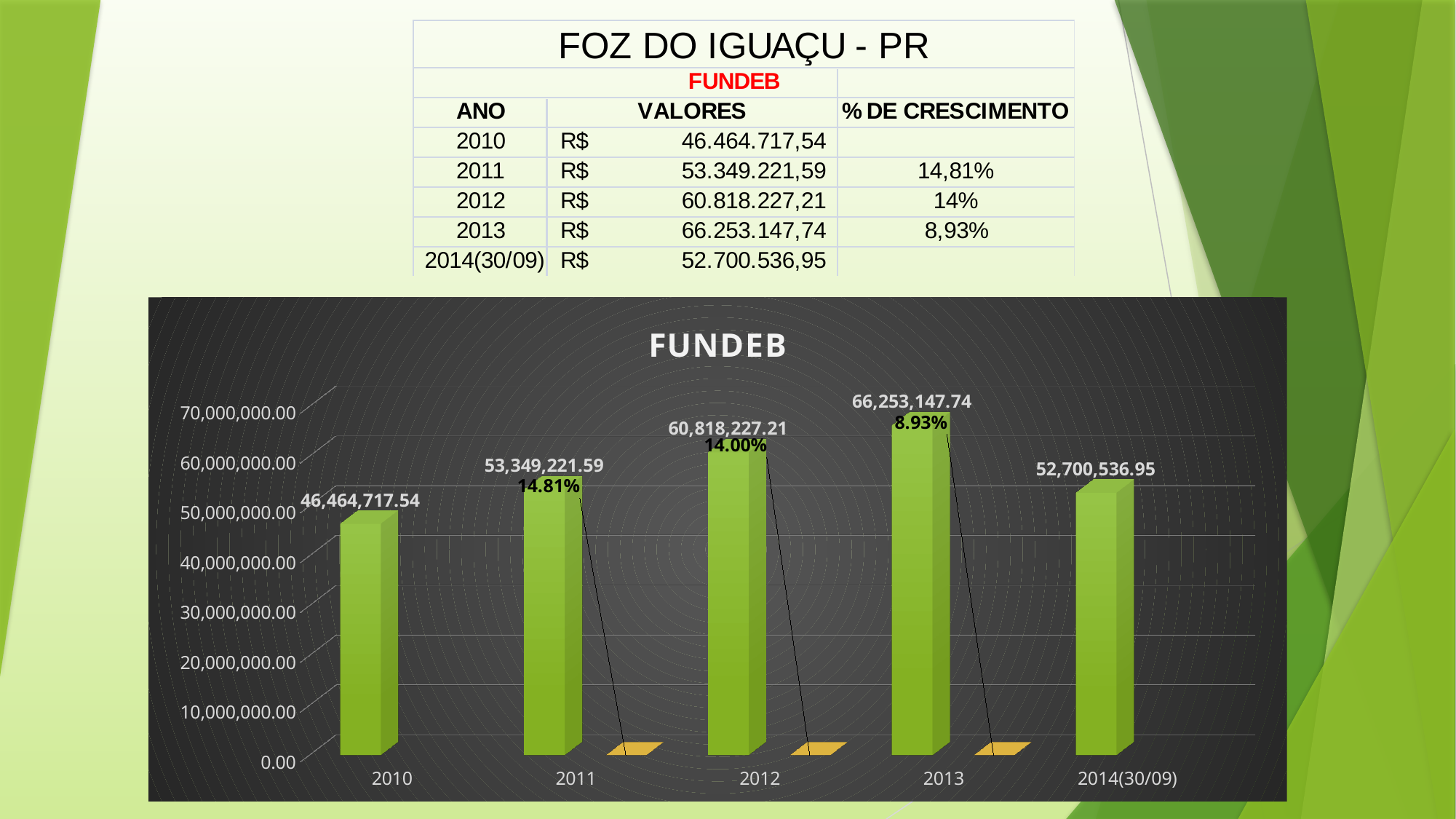
What is the difference between the 2013 and 2014(30/09) values in the FUNDEB chart? 13,552,610.79 Which is larger in the FUNDEB chart, the value for 2012 or the value for 2014(30/09)? 2012 Which year has the lowest value in the FUNDEB chart? 2010 What is the value for 2014(30/09) in the FUNDEB chart? 52,700,536.95 What kind of chart is the FUNDEB chart? bar chart Is the value for 2010 in the FUNDEB chart greater or less than 50,000,000.00? less What is the value for 2010 in the FUNDEB chart? 46,464,717.54 What is the difference between the 2013 and 2010 values in the FUNDEB chart? 19,788,430.20 Which year has the highest value in the FUNDEB chart? 2013 What is the value for 2013 in the FUNDEB chart? 66,253,147.74 What growth percentage is shown above the 2011 bar in the FUNDEB chart? 14.81% How many years are shown on the x axis of the FUNDEB chart? 5